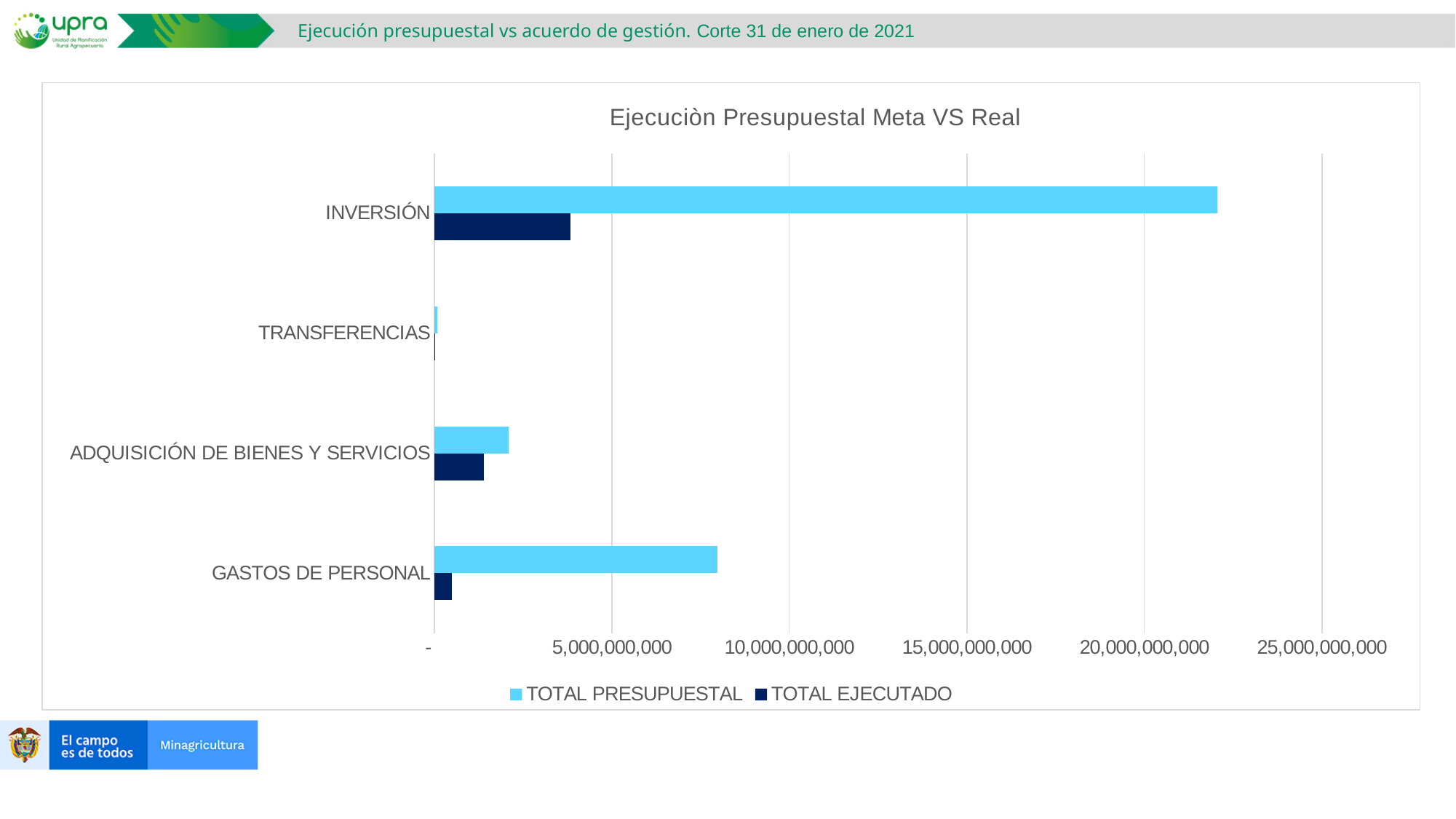
Which category has the highest TOTAL EJECUTADO value? INVERSIÓN Is the TOTAL PRESUPUESTAL value for INVERSIÓN greater or less than 20,000,000,000? greater What kind of chart is shown on the slide? Bar chart How many series does the legend list? 2 Which series is shown in dark blue in the legend? TOTAL EJECUTADO Is the TOTAL PRESUPUESTAL value for GASTOS DE PERSONAL greater or less than 10,000,000,000? less Which is larger for GASTOS DE PERSONAL: TOTAL PRESUPUESTAL or TOTAL EJECUTADO? TOTAL PRESUPUESTAL Is the TOTAL EJECUTADO value for INVERSIÓN greater or less than 5,000,000,000? less Which category has the highest TOTAL PRESUPUESTAL value? INVERSIÓN How many categories are shown on the chart? 4 Which category has the lowest TOTAL PRESUPUESTAL value? TRANSFERENCIAS What is the title of the chart? Ejecuciòn Presupuestal Meta VS Real